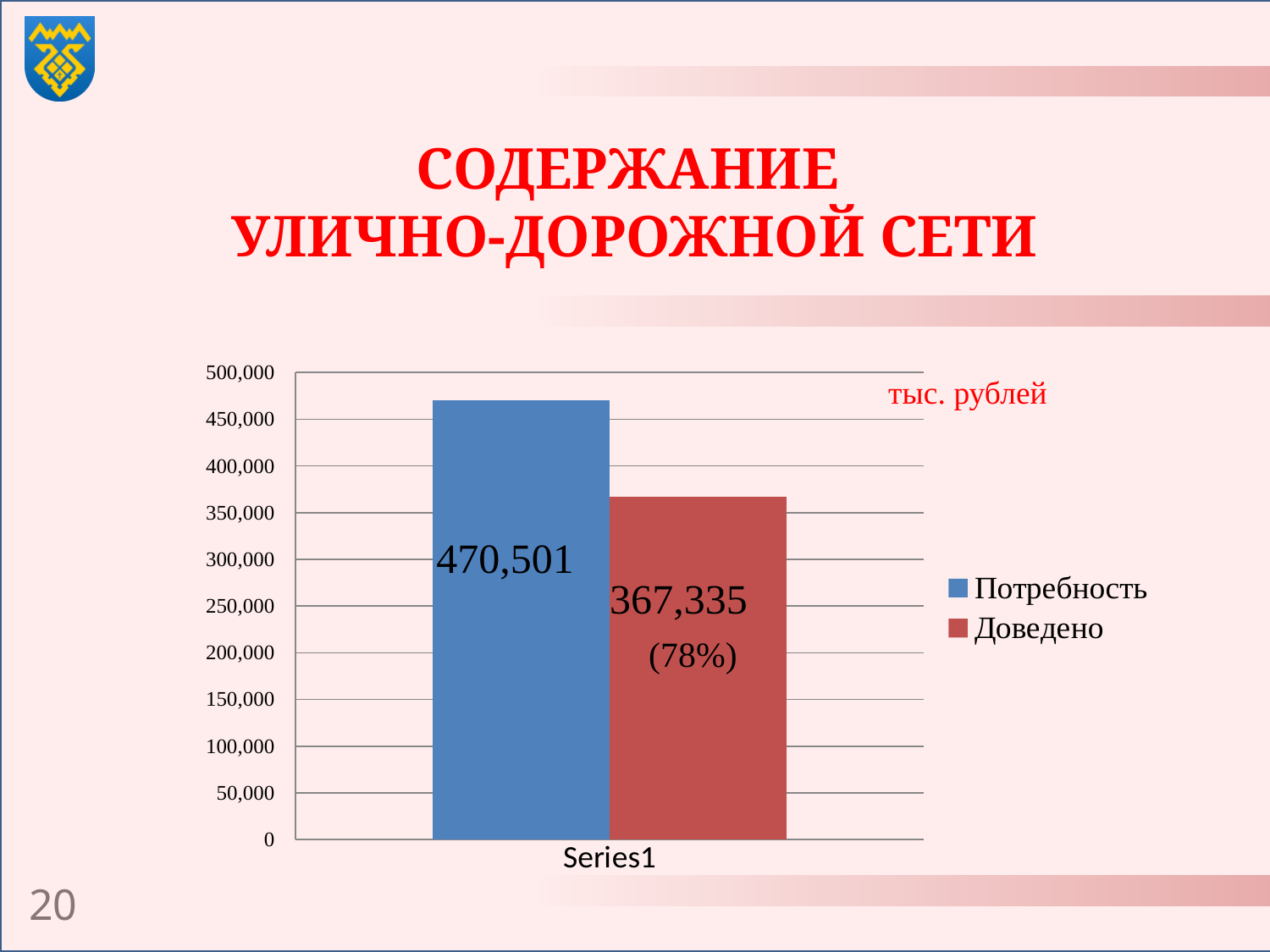
Which series has the lowest value? Доведено What unit is indicated in the chart area? тыс. рублей What percentage is shown in parentheses on the Доведено bar? 78% Which series has the higher value, Потребность or Доведено? Потребность What kind of chart is shown on the slide? bar chart What is the value for Доведено? 367,335 Is the value for Доведено greater or less than 400,000? less What is the value for Потребность? 470,501 How many series does the legend list? 2 What is the difference between the Потребность and Доведено values? 103,166 Is the value for Потребность greater or less than 450,000? greater What colour is the Доведено bar? red